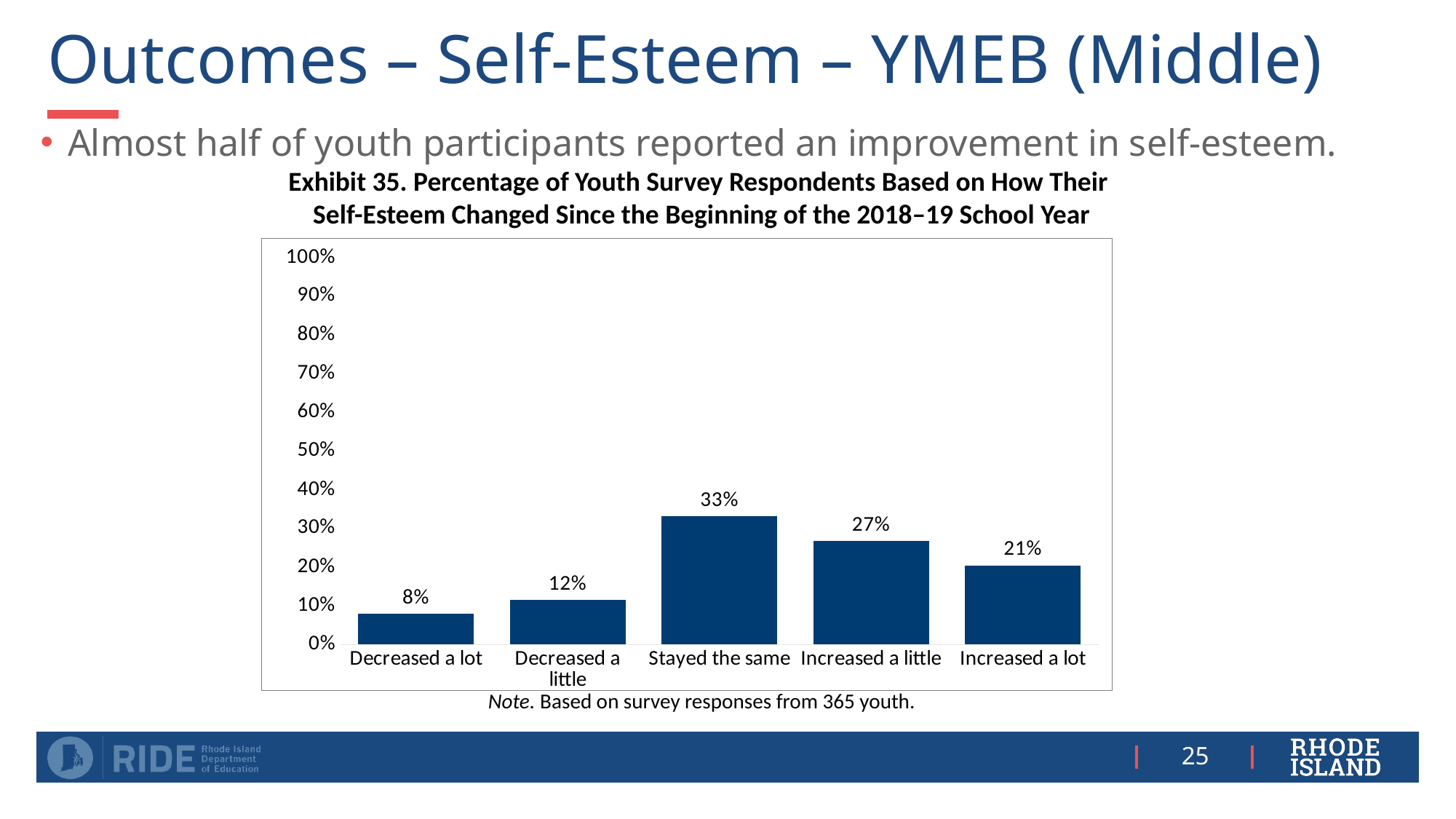
Is the value for "Stayed the same" greater or less than 30%? greater What kind of chart is shown on the slide? Bar chart What percentage of respondents reported their self-esteem "Decreased a little"? 12% What percentage of respondents reported their self-esteem "Increased a lot"? 21% How many categories are shown on the x axis of the chart? 5 Which category has the highest percentage of respondents? Stayed the same What percentage of respondents reported their self-esteem "Stayed the same"? 33% Which is larger, the percentage for "Increased a little" or for "Increased a lot"? Increased a little According to the note below the chart, how many youth survey responses is the chart based on? 365 Which category has the lowest percentage of respondents? Decreased a lot What is the combined percentage of respondents who reported their self-esteem "Increased a little" or "Increased a lot"? 48% What is the difference in percentage points between "Increased a little" and "Decreased a lot"? 19 percentage points